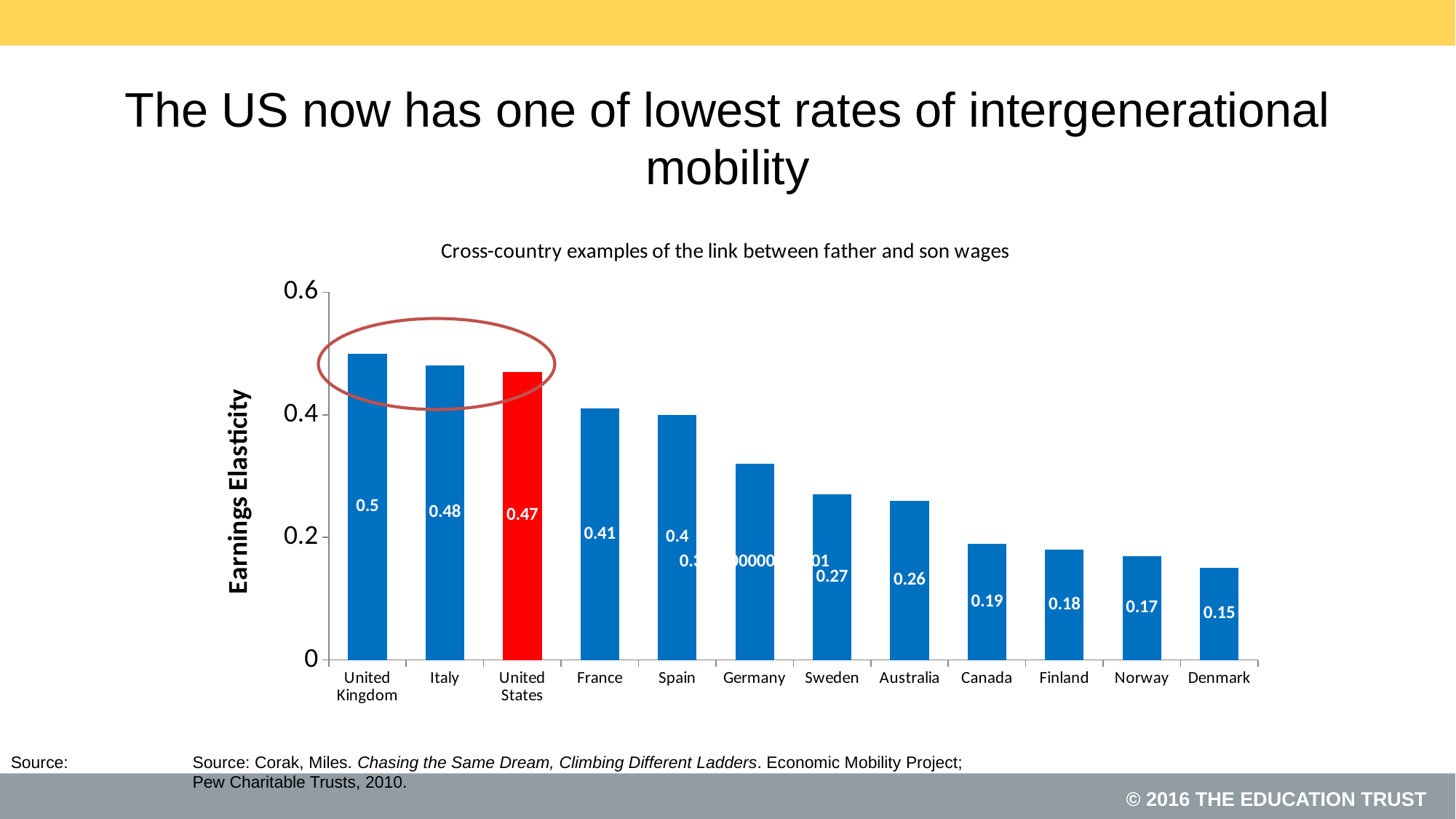
What is the earnings elasticity for the United Kingdom? 0.5 Do the values rise or fall moving from left to right along the x axis? Fall Which has a higher earnings elasticity, France or Sweden? France Which country has the highest earnings elasticity? United Kingdom Which country's bar is coloured red? United States What kind of chart is shown on the slide? Bar chart What is the difference in earnings elasticity between the United Kingdom and Denmark? 0.35 What is the earnings elasticity for Canada? 0.19 What is the earnings elasticity for the United States? 0.47 Which country has the lowest earnings elasticity? Denmark Is the value for Germany greater or less than 0.4? less How many countries are shown in the chart? 12